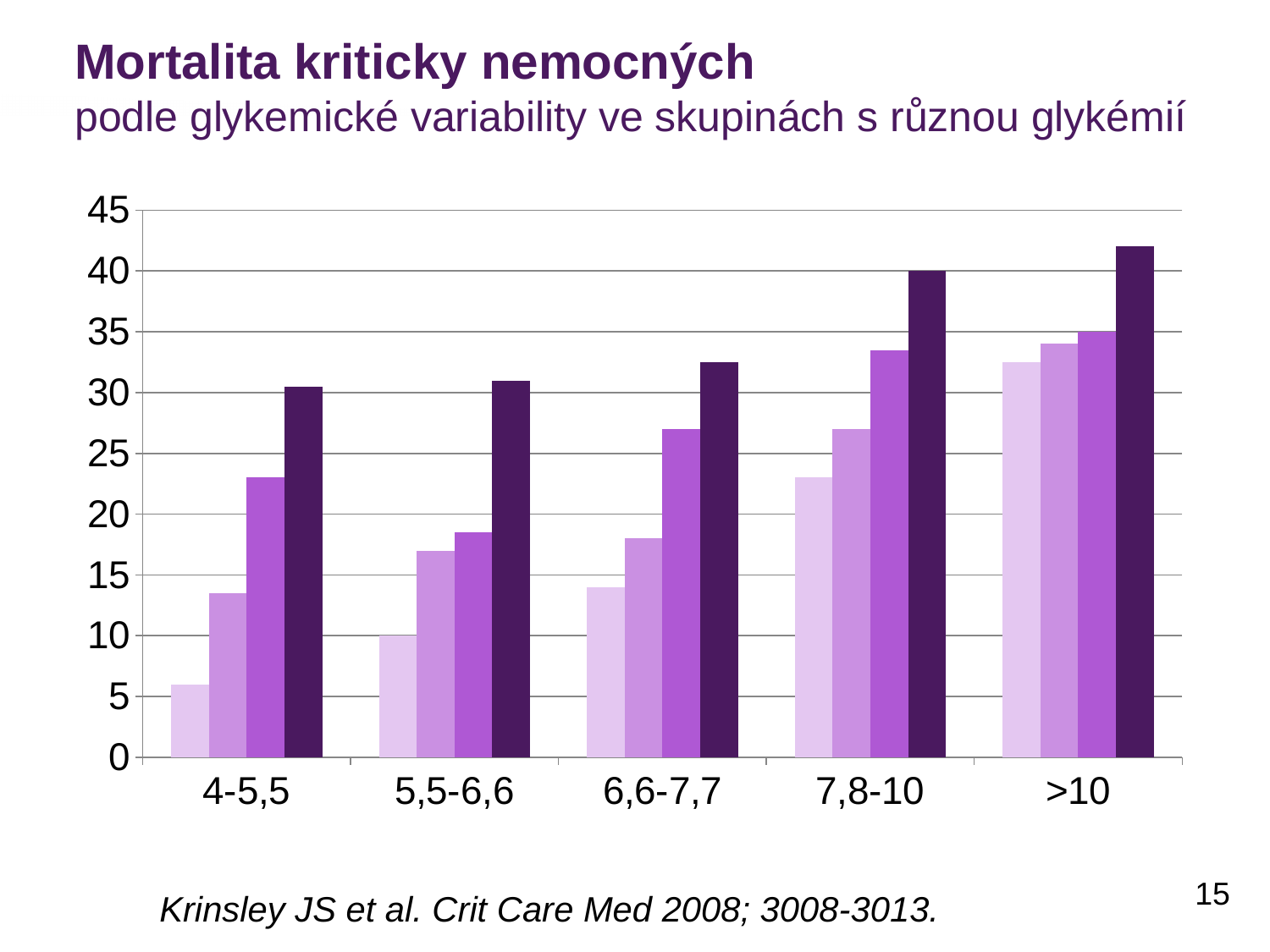
What is the bold title of the slide? Mortalita kriticky nemocných Is the value of the lightest bar in the 6,6-7,7 group greater or less than 15? less What kind of chart is shown on the slide? bar chart How many glycemia groups (categories) are shown on the x axis? 5 What is the value of the lightest (leftmost) bar in the 5,5-6,6 group? 10 In which glycemia group is the darkest (rightmost) bar the highest? >10 In which glycemia group is the lightest (leftmost) bar the lowest? 4-5,5 What is the value of the darkest (rightmost) bar in the 7,8-10 group? 40 Which is larger: the darkest bar in the 5,5-6,6 group or the darkest bar in the 6,6-7,7 group? 6,6-7,7 Do the values of the lightest (leftmost) bars rise or fall from the 4-5,5 group to the >10 group? rise How many bars are plotted for each glycemia group? 4